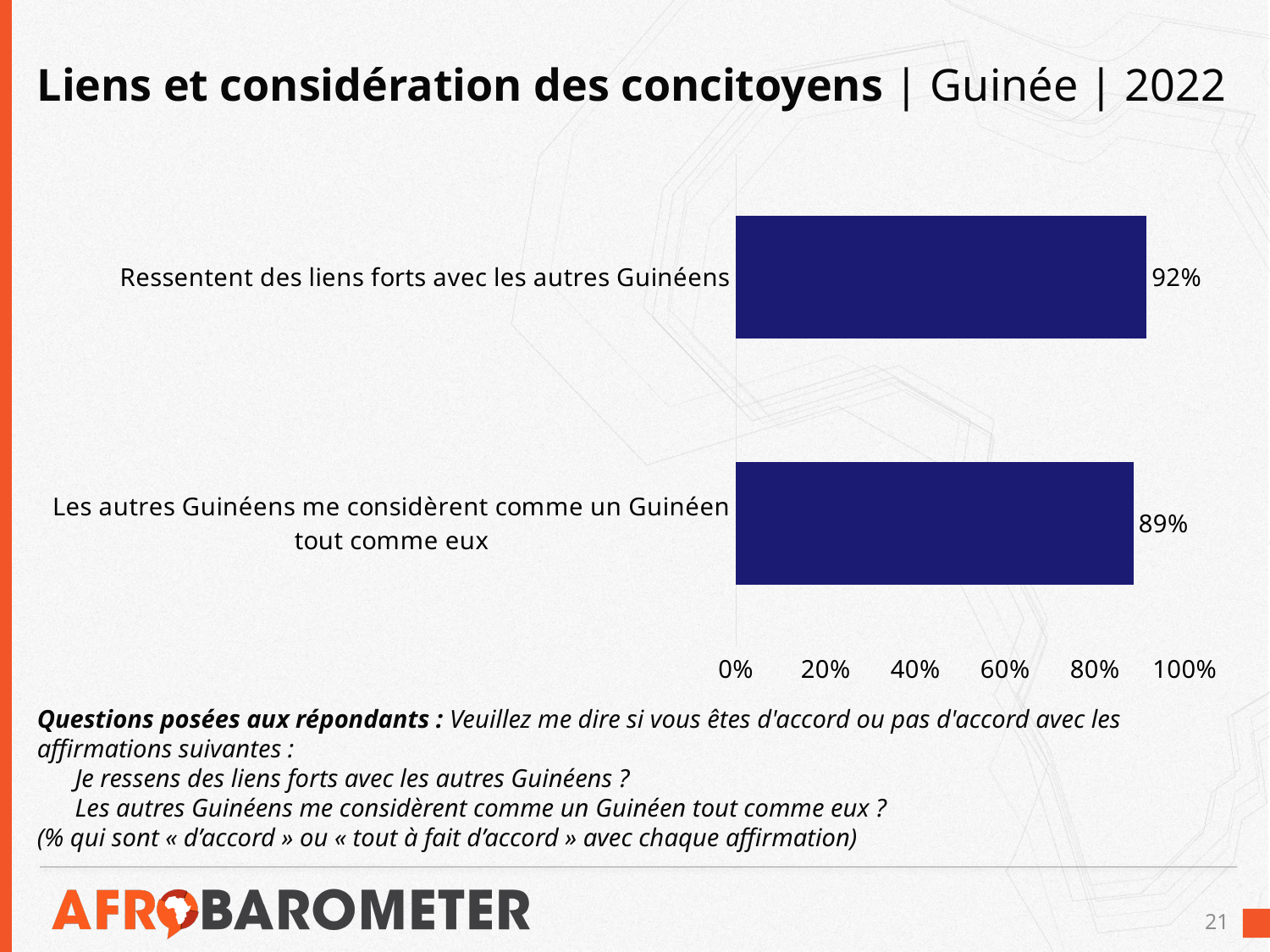
What is the maximum value shown on the x axis? 100% How many categories are shown in the chart? 2 What percentage of respondents feel strong ties with other Guineans ("Ressentent des liens forts avec les autres Guinéens")? 92% What type of chart is shown on the slide? Bar chart What is the difference in percentage points between the two bars? 3 percentage points Which is larger: the value for feeling strong ties with other Guineans or the value for being considered a Guinean like others? Feeling strong ties with other Guineans (92%) What is the value for "Les autres Guinéens me considèrent comme un Guinéen tout comme eux"? 89% Which category has the highest value? Ressentent des liens forts avec les autres Guinéens Is the value for "Les autres Guinéens me considèrent comme un Guinéen tout comme eux" greater or less than 80%? greater Which category has the lowest value? Les autres Guinéens me considèrent comme un Guinéen tout comme eux What is the title of the slide? Liens et considération des concitoyens | Guinée | 2022